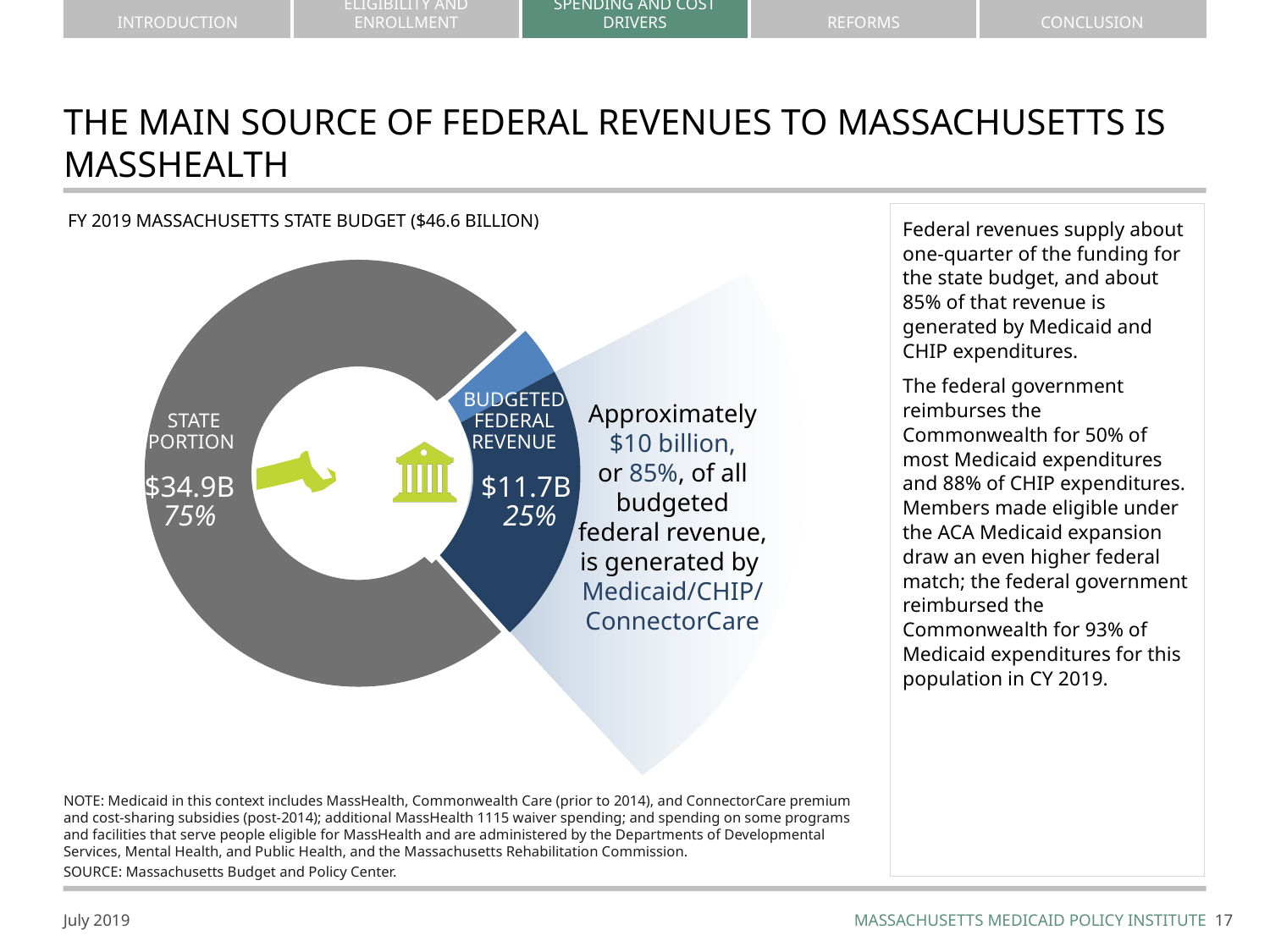
Which segment of the FY 2019 Massachusetts State Budget chart is the largest? State Portion How many segments does the FY 2019 Massachusetts State Budget chart have? 3 What percentage of the FY 2019 Massachusetts State Budget is Budgeted Federal Revenue? 25% What is the dollar value of the State Portion segment in the FY 2019 Massachusetts State Budget chart? $34.9B What is the dollar value of the Budgeted Federal Revenue segment in the FY 2019 Massachusetts State Budget chart? $11.7B In the FY 2019 Massachusetts State Budget chart, which is larger: the State Portion or Budgeted Federal Revenue? State Portion What is the difference in dollars between the State Portion and Budgeted Federal Revenue in the FY 2019 Massachusetts State Budget chart? $23.2B What percentage of the FY 2019 Massachusetts State Budget is the State Portion? 75% According to the callout next to the chart, approximately how much of budgeted federal revenue is generated by Medicaid/CHIP/ConnectorCare? $10 billion, or 85% What total budget amount is given in the title of the FY 2019 Massachusetts State Budget chart? $46.6 billion What kind of chart is used to show the FY 2019 Massachusetts State Budget? Donut (pie) chart